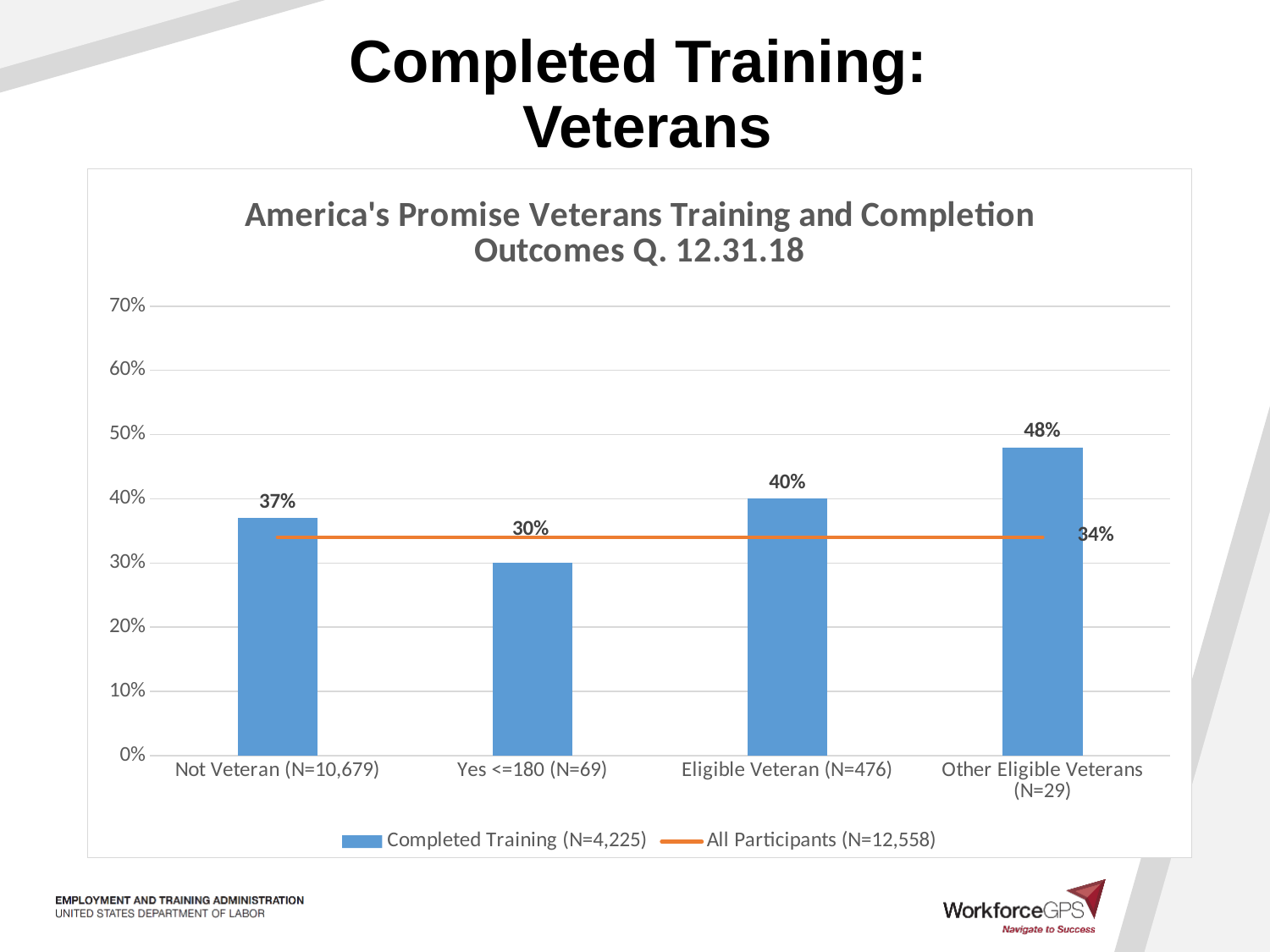
What is the Completed Training value for Eligible Veteran (N=476)? 40% How many series does the legend list? 2 Which category has the highest Completed Training value? Other Eligible Veterans (N=29) What is the Completed Training value for Other Eligible Veterans (N=29)? 48% What is the title of the chart? America's Promise Veterans Training and Completion Outcomes Q. 12.31.18 Which is larger: the Completed Training value for Eligible Veteran (N=476) or for Not Veteran (N=10,679)? Eligible Veteran (N=476) How many categories are shown on the x axis? 4 What is the difference between the Completed Training values for Other Eligible Veterans (N=29) and Yes <=180 (N=69)? 18% What is the Completed Training value for Not Veteran (N=10,679)? 37% What value is shown for the All Participants (N=12,558) line? 34% Which category has the lowest Completed Training value? Yes <=180 (N=69) What is the Completed Training value for Yes <=180 (N=69)? 30%